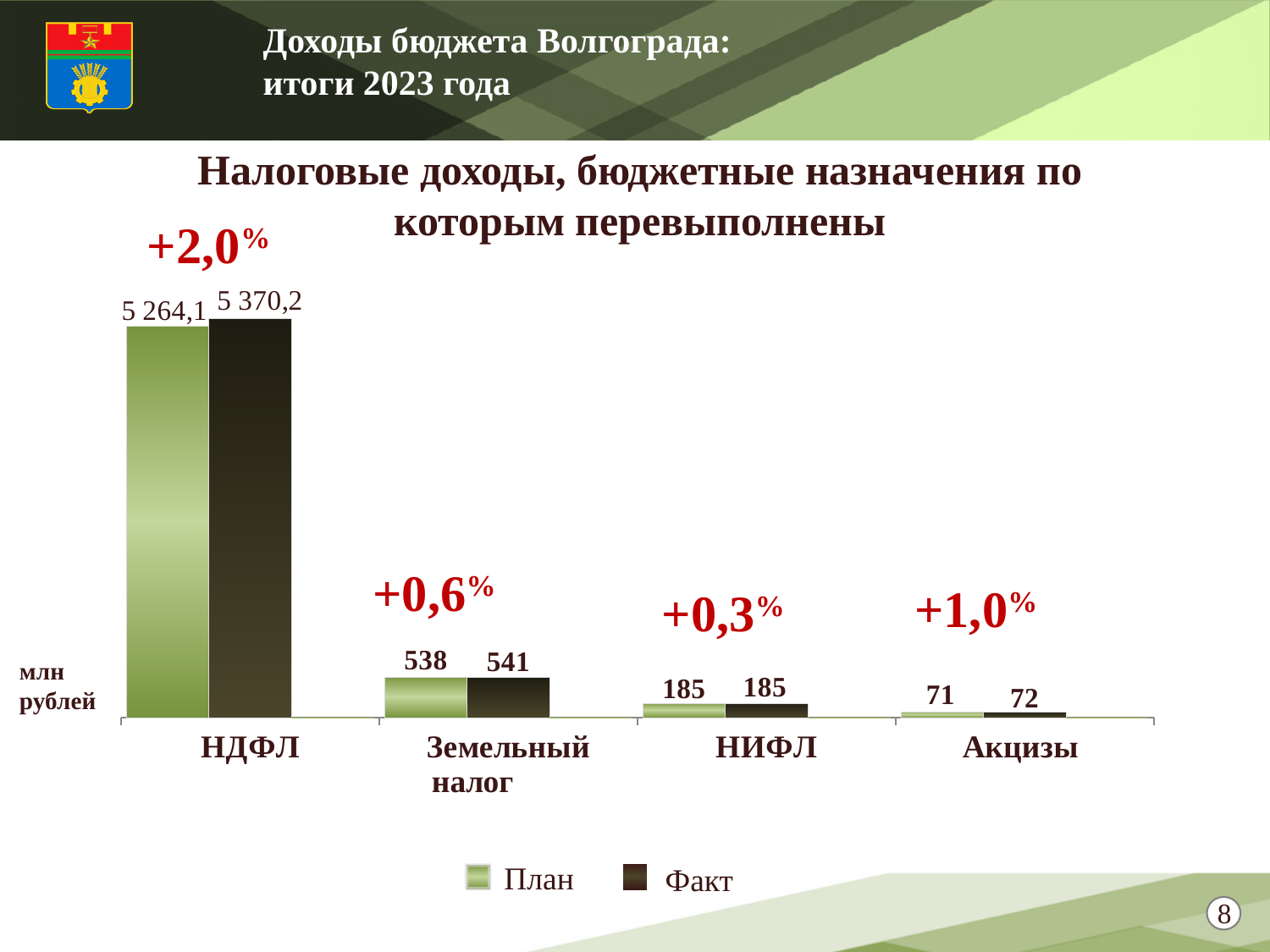
How many series does the legend list? 2 What is the Факт value for Земельный налог? 541 What percentage is shown above the НИФЛ bars? +0,3% What is the План value for Акцизы? 71 How many categories are shown on the x axis? 4 What is the Факт value for НДФЛ? 5 370,2 What kind of chart is shown on the slide? Bar chart What is the difference between the Факт and План values for Земельный налог? 3 What is the План value for НДФЛ? 5 264,1 Which category has the highest Факт value? НДФЛ Which category has the lowest План value? Акцизы Which is larger for Акцизы, the План value or the Факт value? Факт